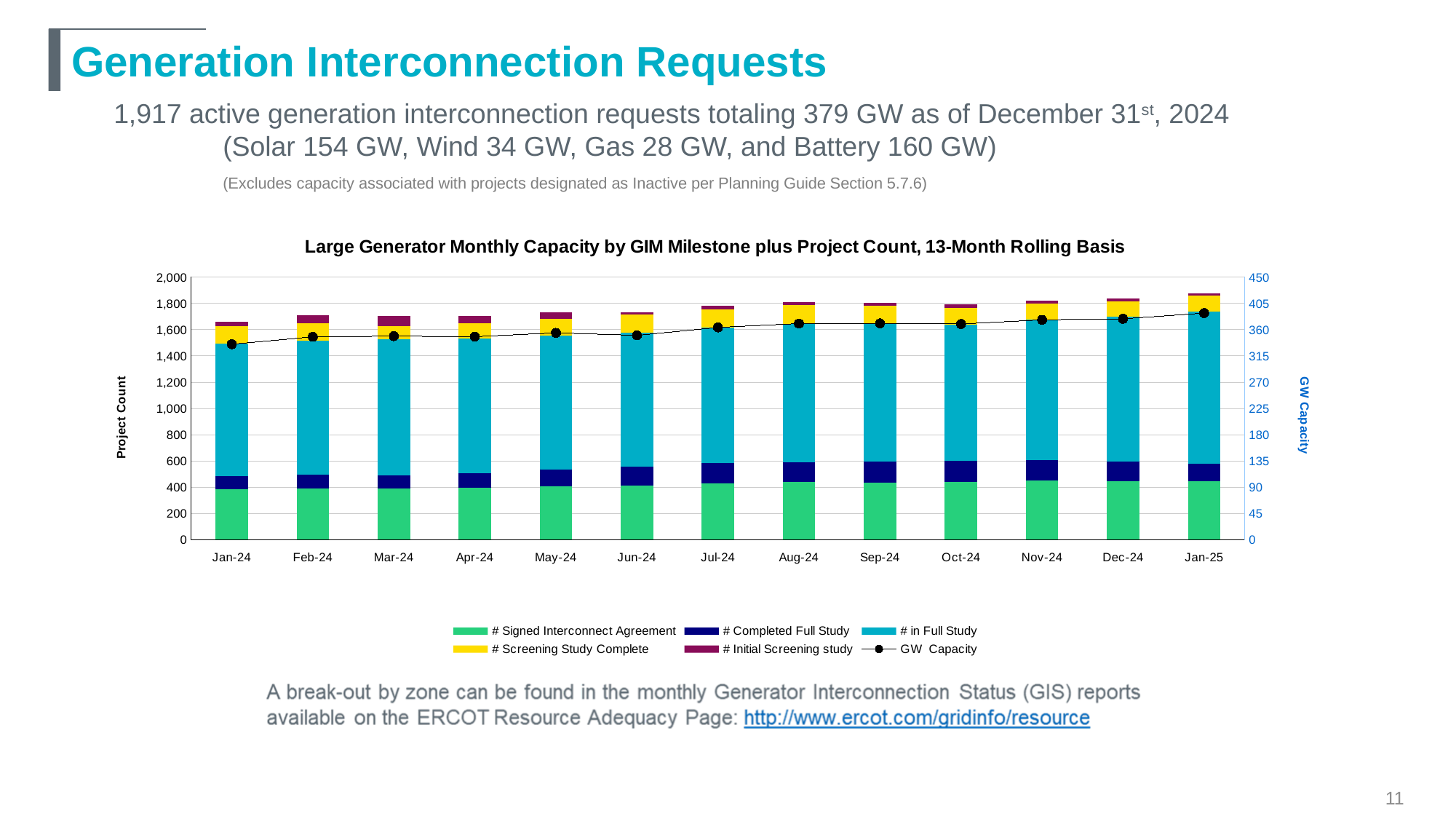
What type of chart is shown on the slide? Stacked bar chart with a line Which month has the highest GW Capacity value? Jan-25 What is the label of the right-hand vertical axis of the chart? GW Capacity How many months are shown on the x axis of the chart? 13 Does the GW Capacity line generally rise or fall from Jan-24 to Jan-25? rise Is the total project count for Jan-25 greater or less than 1,800? greater Is the GW Capacity value for Jan-25 greater or less than 360? greater How many series does the chart legend list? 6 Is the GW Capacity value for Jan-24 greater or less than 360? less Which month has the tallest stacked bar (highest total project count)? Jan-25 Which is larger, the total project count for Jan-25 or for Jan-24? Jan-25 Which month has the lowest GW Capacity value? Jan-24